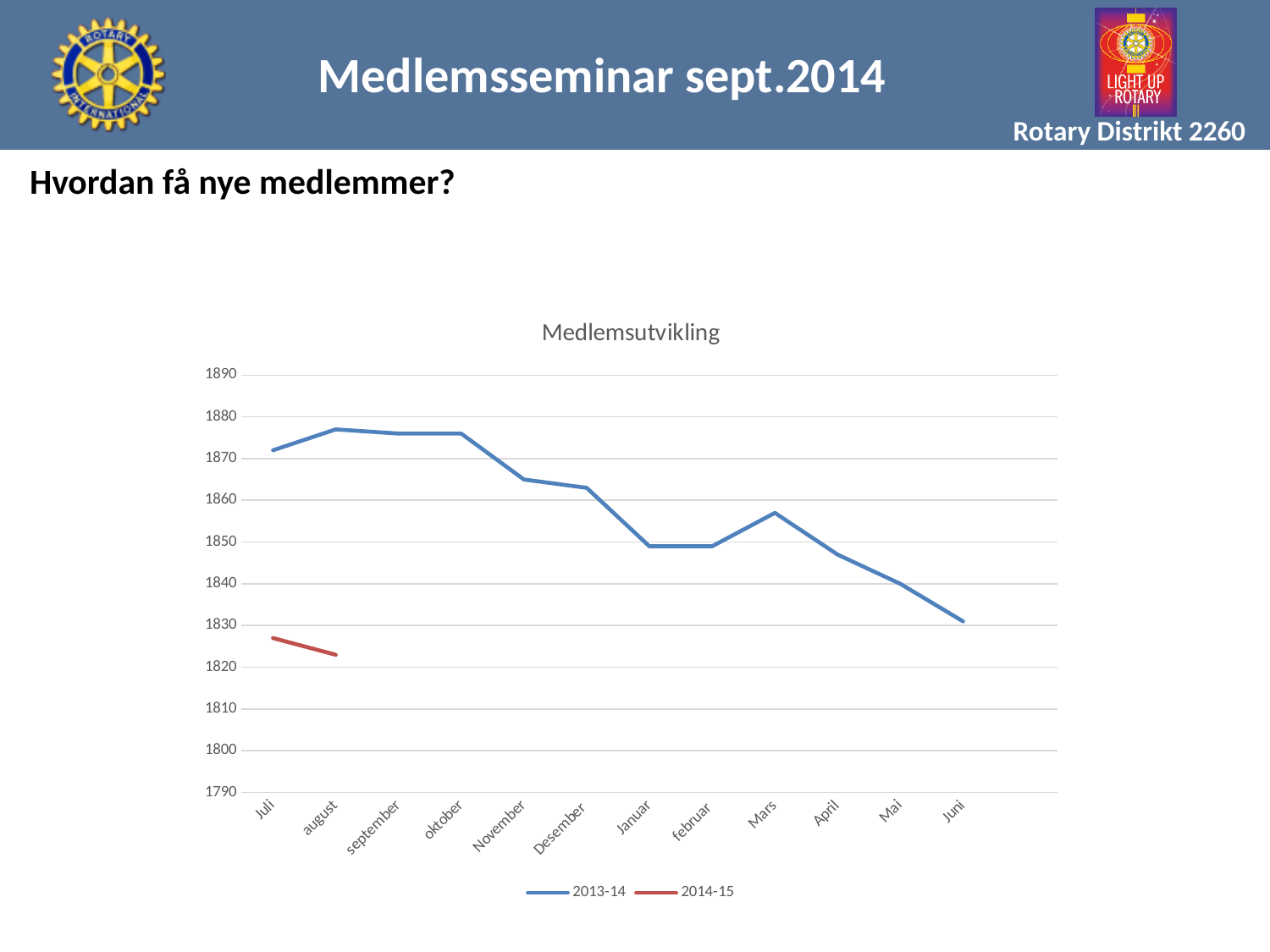
Is the value for Januar in the 2013-14 series greater or less than 1860? less Does the 2013-14 series overall rise or fall from Juli to Juni? fall For Juli, which series has the higher value, 2013-14 or 2014-15? 2013-14 Is the value for Juli in the 2014-15 series greater or less than 1830? less What is the title of the chart? Medlemsutvikling How many series does the legend list? 2 In which month is the 2013-14 series at its lowest? Juni Is the value for Juni in the 2013-14 series greater or less than 1840? less How many months are shown on the x axis? 12 What kind of chart is shown on the slide? line chart Which series is drawn in red? 2014-15